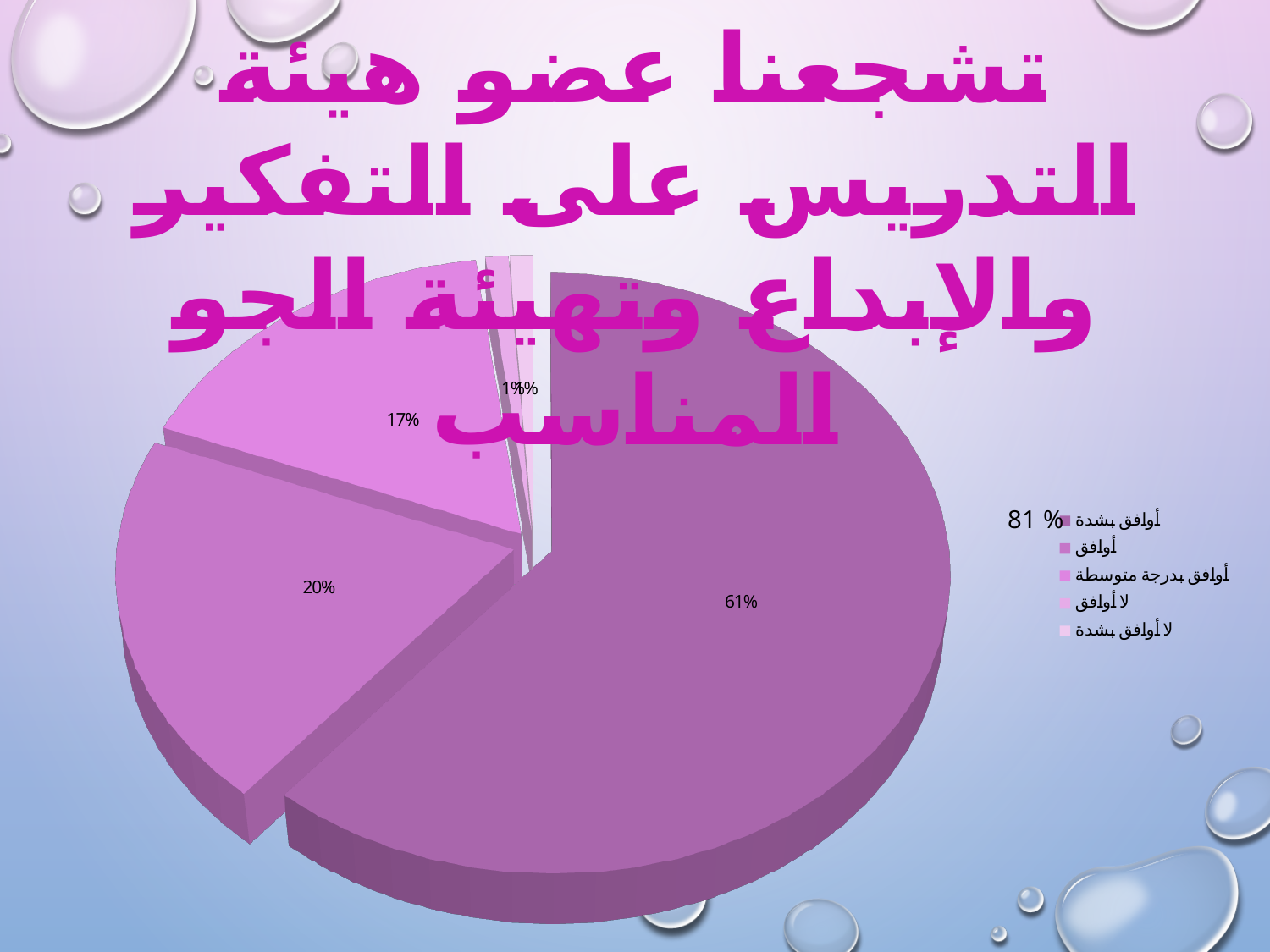
What percentage is shown for أوافق in the pie chart? 20% What percentage is shown for أوافق بشدة in the pie chart? 61% What percentage is shown for أوافق بدرجة متوسطة in the pie chart? 17% What kind of chart is shown on the slide? pie chart What is the difference in percentage points between the أوافق slice and the أوافق بدرجة متوسطة slice? 3 What number is printed next to the legend of the pie chart? 81 % How many categories does the legend of the pie chart list? 5 Which slice is larger, أوافق or أوافق بدرجة متوسطة? أوافق What is the combined share of the أوافق بشدة and أوافق slices? 81% What percentage is shown for لا أوافق in the pie chart? 1% What is the difference in percentage points between the أوافق بشدة slice and the أوافق slice? 41 Which category has the largest slice of the pie chart? أوافق بشدة